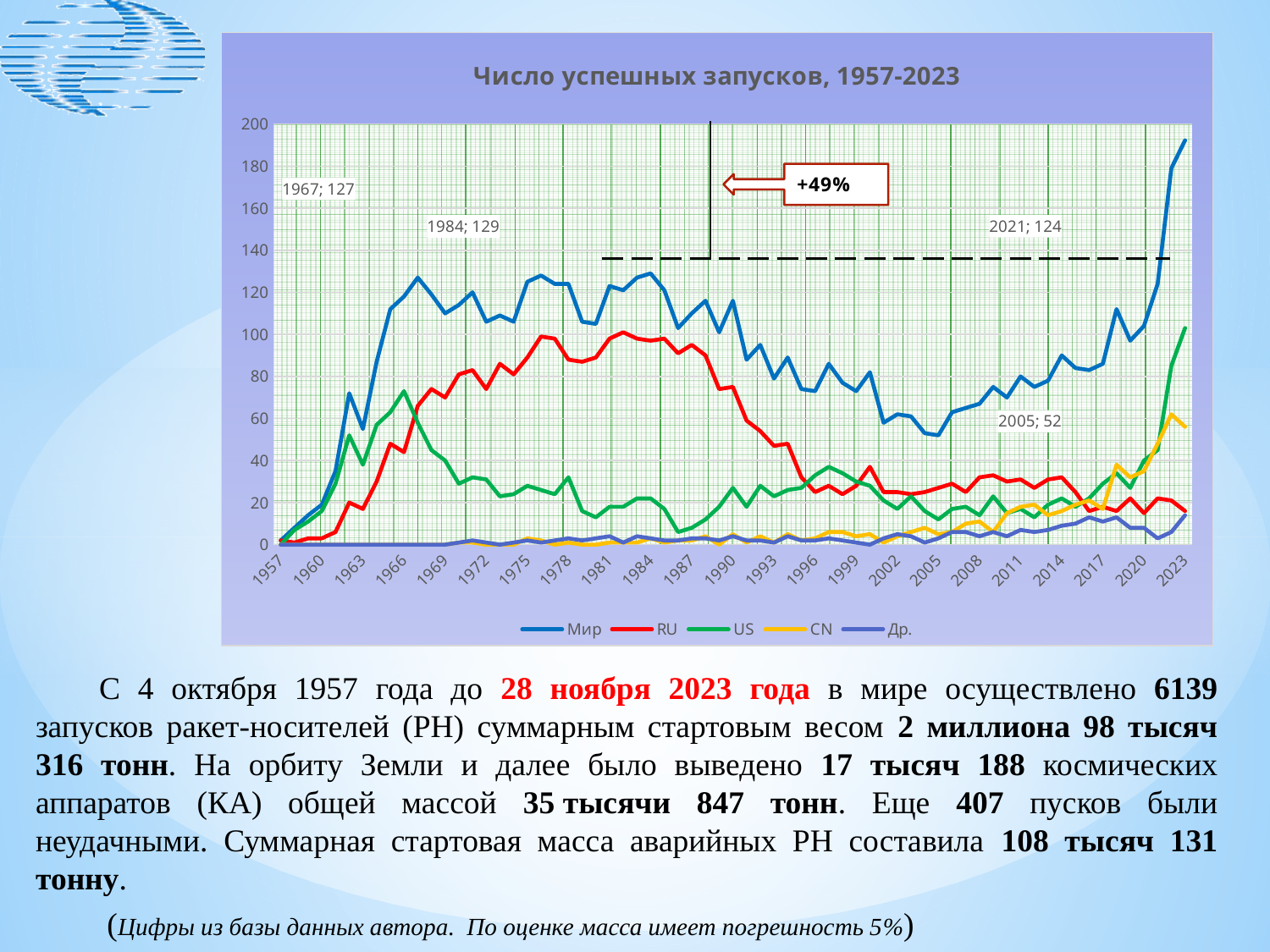
What is the title of the chart? Число успешных запусков, 1957-2023 What is the difference between the labelled Мир values for 1967 and 2005? 75 Does the Мир series rise or fall between 2005 and 2023? rise What is the labelled value for the Мир series in 1984? 129 What is the labelled value for the Мир series in 2005? 52 What kind of chart is shown on the slide? line chart Is the value for the Мир series in 2023 greater or less than 180? greater In 2023, which series has the higher value, US or RU? US What is the labelled value for the Мир series in 1967? 127 What is the difference between the labelled Мир values for 1984 and 1967? 2 What is the labelled value for the Мир series in 2021? 124 How many series does the chart legend list? 5